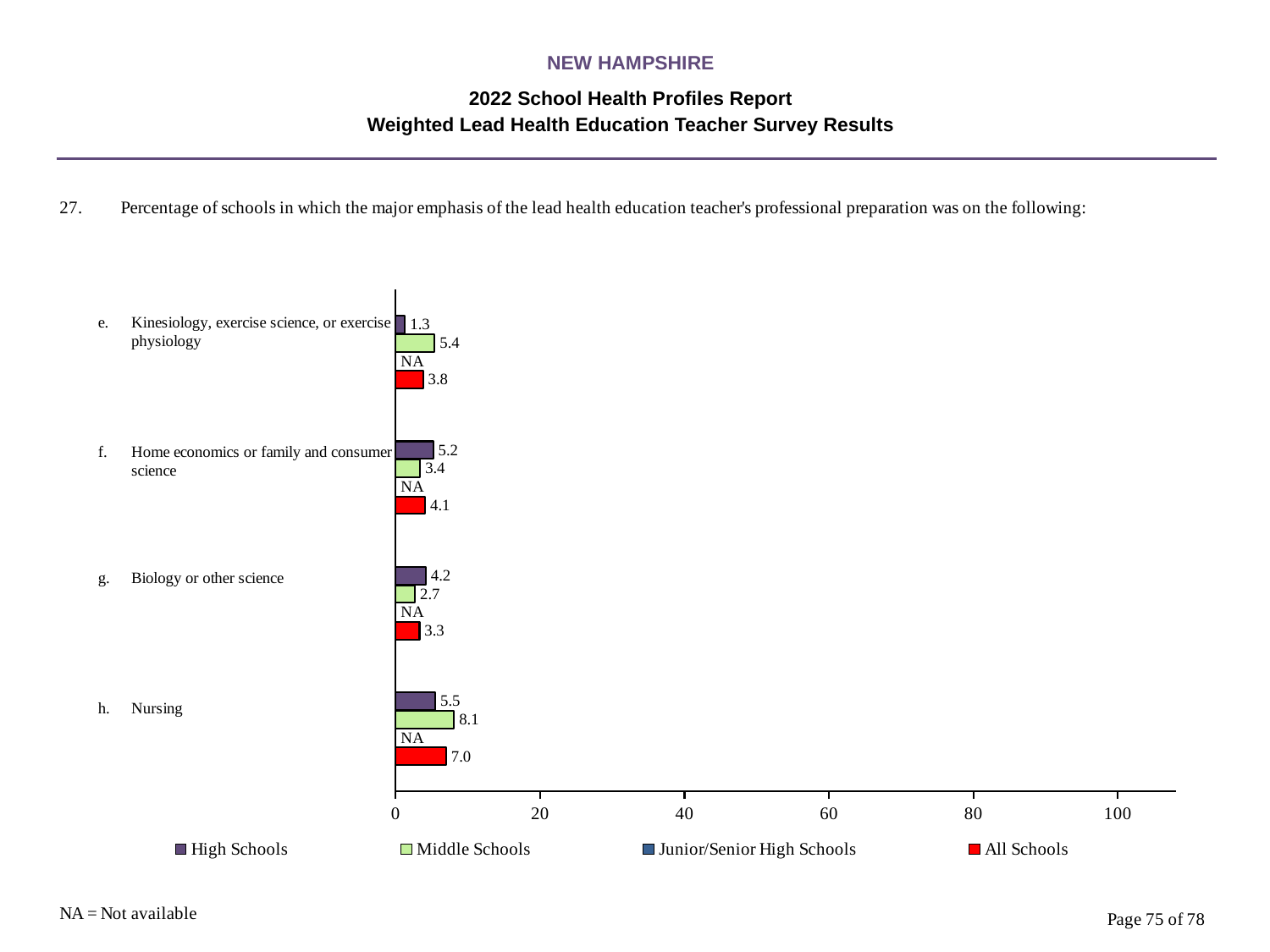
What is the difference between the Middle Schools and High Schools values for Nursing? 2.6 What kind of chart is shown on the slide? bar chart What is the value for High Schools for Kinesiology, exercise science, or exercise physiology? 1.3 Which category has the lowest High Schools value? Kinesiology, exercise science, or exercise physiology Is the All Schools value for Nursing greater or less than 20? less What is the value for All Schools for Home economics or family and consumer science? 4.1 Which category has the highest All Schools value? Nursing How many series does the legend list? 4 How many categories are shown on the chart? 4 What is the value for Junior/Senior High Schools for Biology or other science? NA For Biology or other science, which is larger: the High Schools value or the Middle Schools value? High Schools What is the value for Middle Schools for Nursing? 8.1